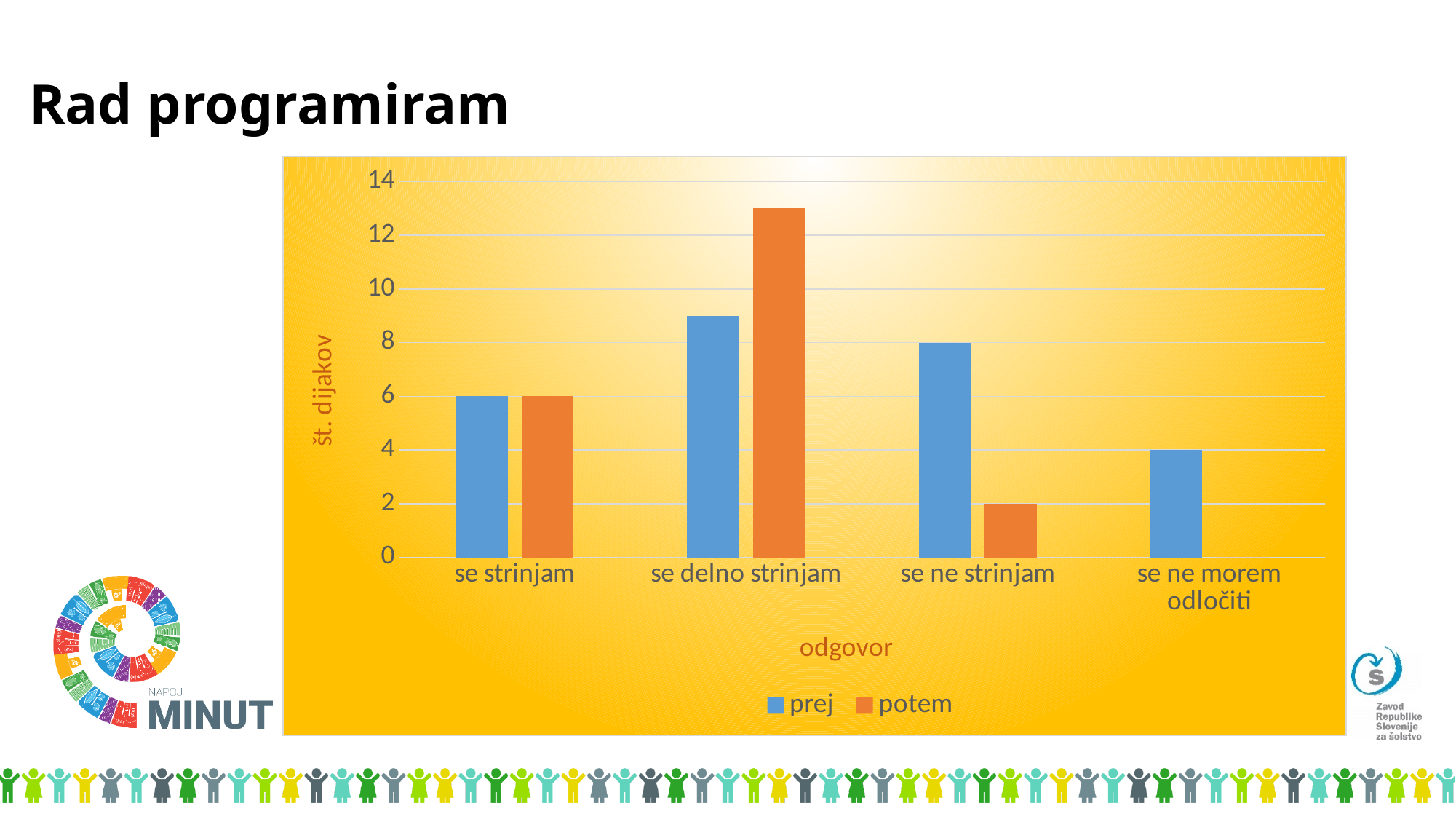
What is the value of 'potem' for 'se ne strinjam'? 2 Is the value of 'potem' for 'se delno strinjam' greater or less than 12? greater What kind of chart is shown on the slide? bar chart What is the value of 'prej' for 'se strinjam'? 6 What is the difference between 'prej' and 'potem' for 'se ne strinjam'? 6 Which category has the highest 'potem' value? se delno strinjam What is the value of 'potem' for 'se strinjam'? 6 How many categories are shown on the x axis? 4 Is the value of 'prej' for 'se delno strinjam' greater or less than 10? less How many series does the legend list? 2 What is the value of 'prej' for 'se ne morem odločiti'? 4 What is the value of 'prej' for 'se ne strinjam'? 8